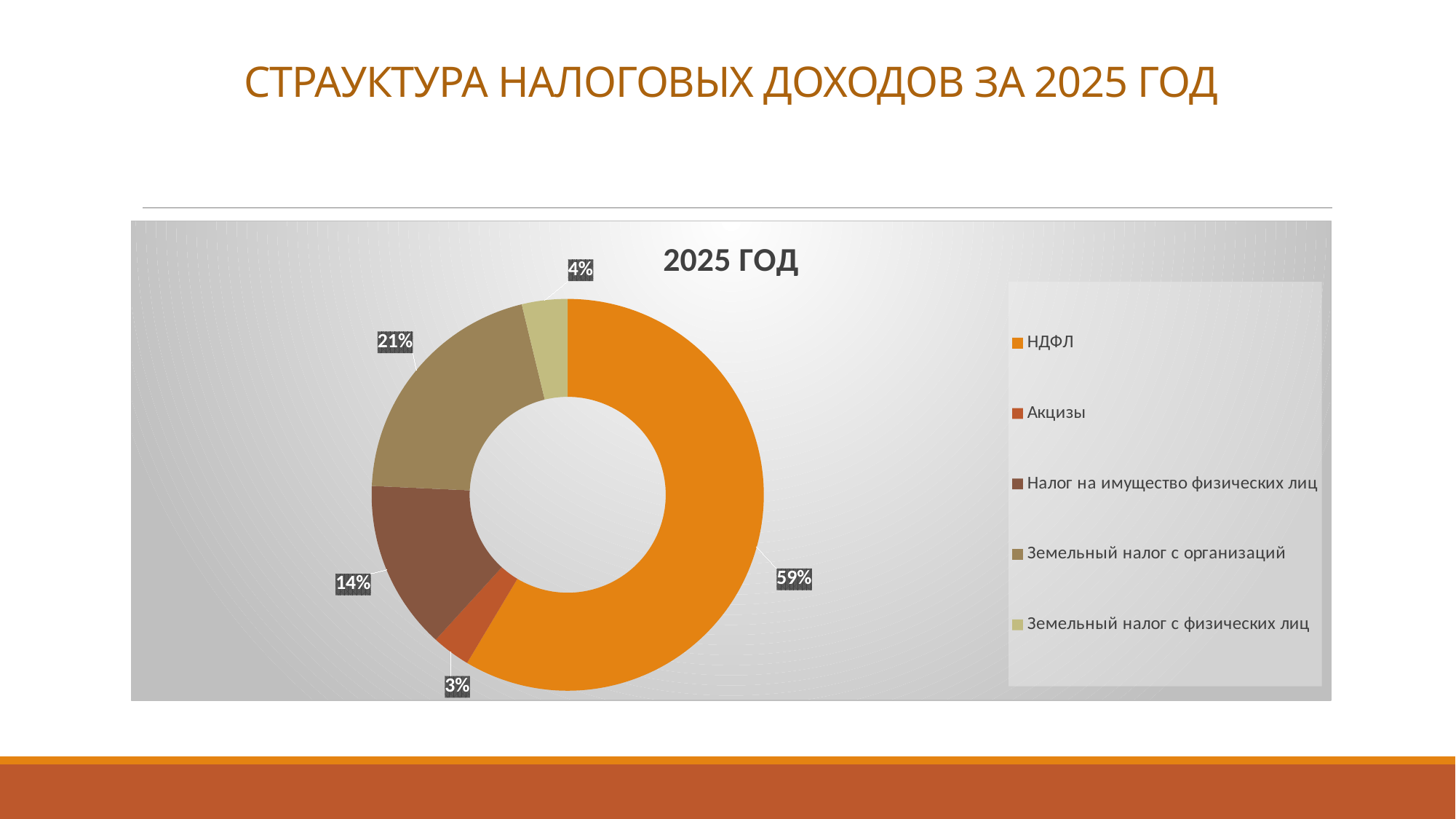
What is the difference in percentage points between НДФЛ and Земельный налог с организаций? 38 What share of the 2025 ГОД chart does Налог на имущество физических лиц account for? 14% Which category has the smallest share in the 2025 ГОД chart? Акцизы What share of the 2025 ГОД chart does Земельный налог с физических лиц account for? 4% What is the title of the chart? 2025 ГОД What share of the 2025 ГОД chart does Акцизы account for? 3% Which is larger: the share for Налог на имущество физических лиц or the share for Земельный налог с организаций? Земельный налог с организаций How many categories are shown in the 2025 ГОД chart? 5 What kind of chart is shown on the slide? Doughnut (pie) chart Which category has the largest share in the 2025 ГОД chart? НДФЛ